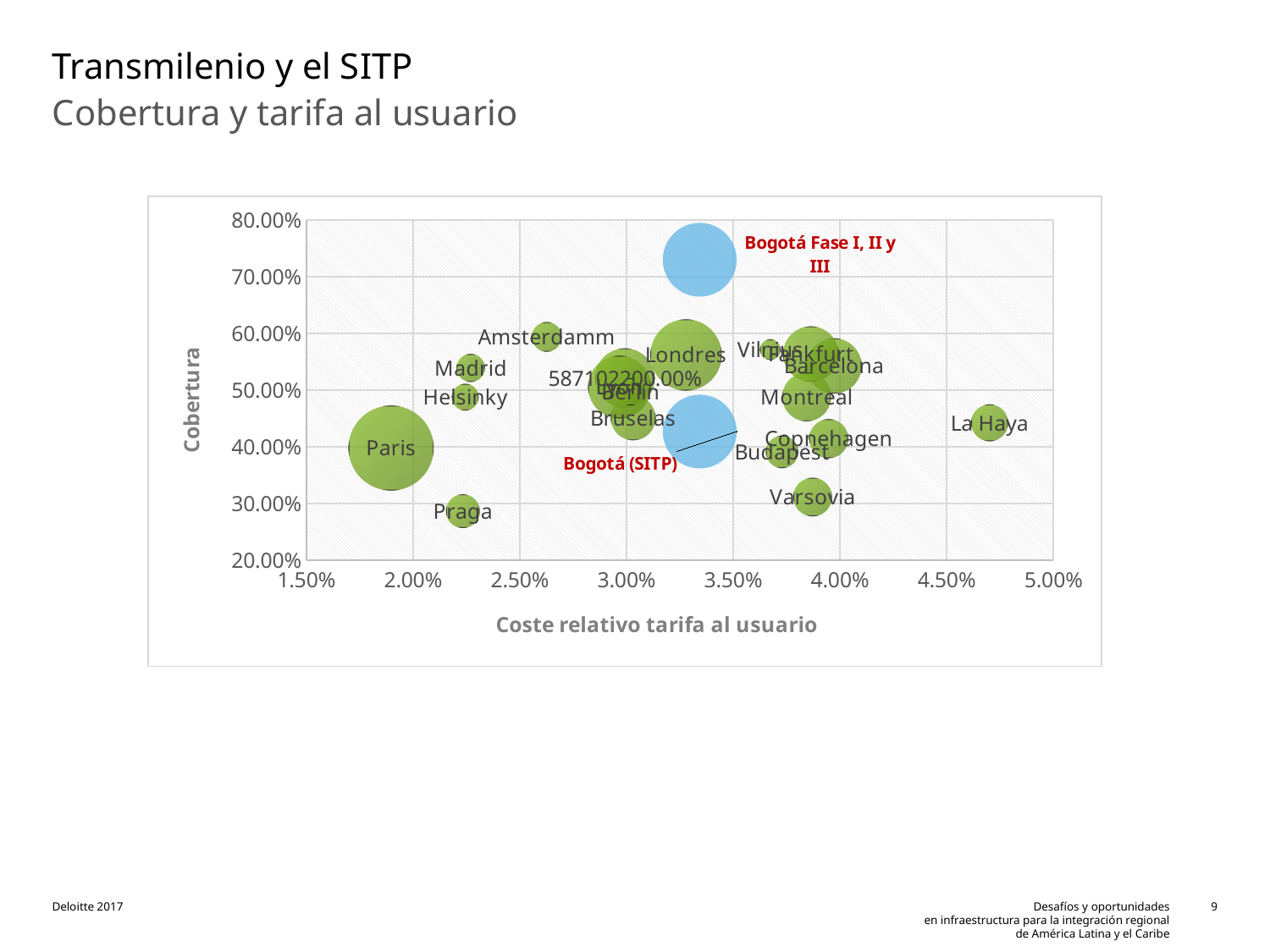
Which city has the lowest Cobertura in the chart? Praga Is the Cobertura for Bogotá Fase I, II y III greater or less than 70.00%? greater Which city has the highest Coste relativo tarifa al usuario in the chart? La Haya What kind of chart is shown on the slide? Bubble chart Which city has the lowest Coste relativo tarifa al usuario in the chart? Paris What is the title of the vertical axis of the chart? Cobertura Is the Cobertura for Varsovia greater or less than 40.00%? less Is the Coste relativo tarifa al usuario for La Haya greater or less than 4.50%? greater Which city has the highest Cobertura in the chart? Bogotá Fase I, II y III Which has the higher Cobertura, Bogotá Fase I, II y III or Bogotá (SITP)? Bogotá Fase I, II y III What is the title of the horizontal axis of the chart? Coste relativo tarifa al usuario Which has the higher Cobertura, Amsterdamm or Praga? Amsterdamm